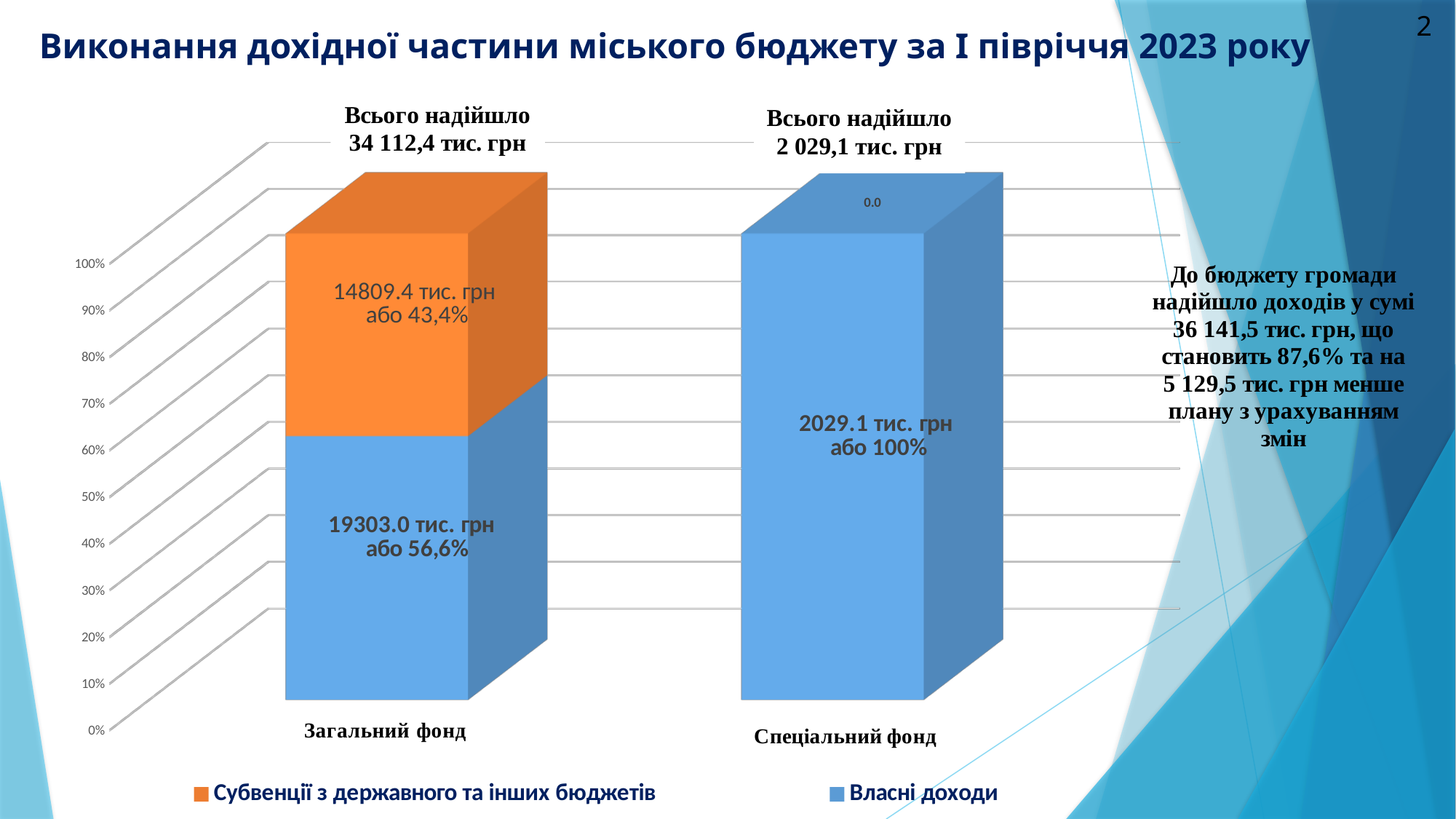
What percentage share does Субвенції з державного та інших бюджетів make up of Загальний фонд? 43,4% Within Загальний фонд, which is larger: Власні доходи or Субвенції з державного та інших бюджетів? Власні доходи What percentage share does Власні доходи make up of Загальний фонд? 56,6% What is the total amount received (Всього надійшло) for Спеціальний фонд? 2 029,1 тис. грн What is the value of Власні доходи for Спеціальний фонд? 2029.1 тис. грн How many series does the chart legend list? 2 How many categories are shown on the x axis of the chart? 2 What kind of chart is shown on the slide? Stacked bar chart What is the value of Власні доходи for Загальний фонд? 19303.0 тис. грн What is the total amount received (Всього надійшло) for Загальний фонд? 34 112,4 тис. грн What is the value of Субвенції з державного та інших бюджетів for Загальний фонд? 14809.4 тис. грн Which colour represents Субвенції з державного та інших бюджетів in the chart? Orange